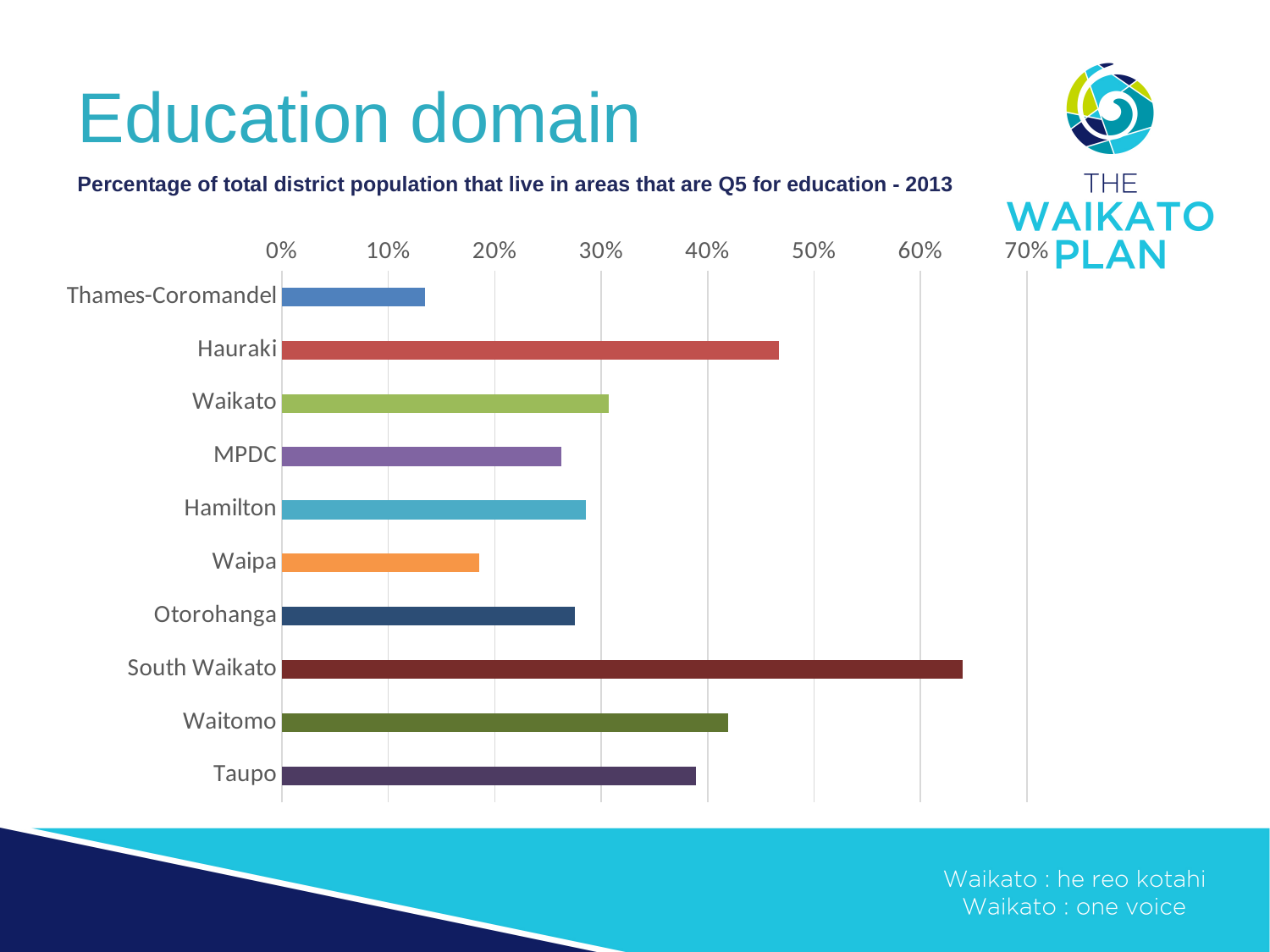
Is the value for Waipa greater or less than 20%? less Which has a higher value, Waipa or Waikato? Waikato Is the value for Hauraki greater or less than 40%? greater Is the value for Thames-Coromandel greater or less than 20%? less Which district has the highest percentage of its population living in areas that are Q5 for education? South Waikato What year does the chart title say the data is for? 2013 Which district has the lowest percentage of its population living in areas that are Q5 for education? Thames-Coromandel What kind of chart is shown on the slide? bar chart Which has a higher value, Hauraki or Waitomo? Hauraki How many districts are plotted in the chart? 10